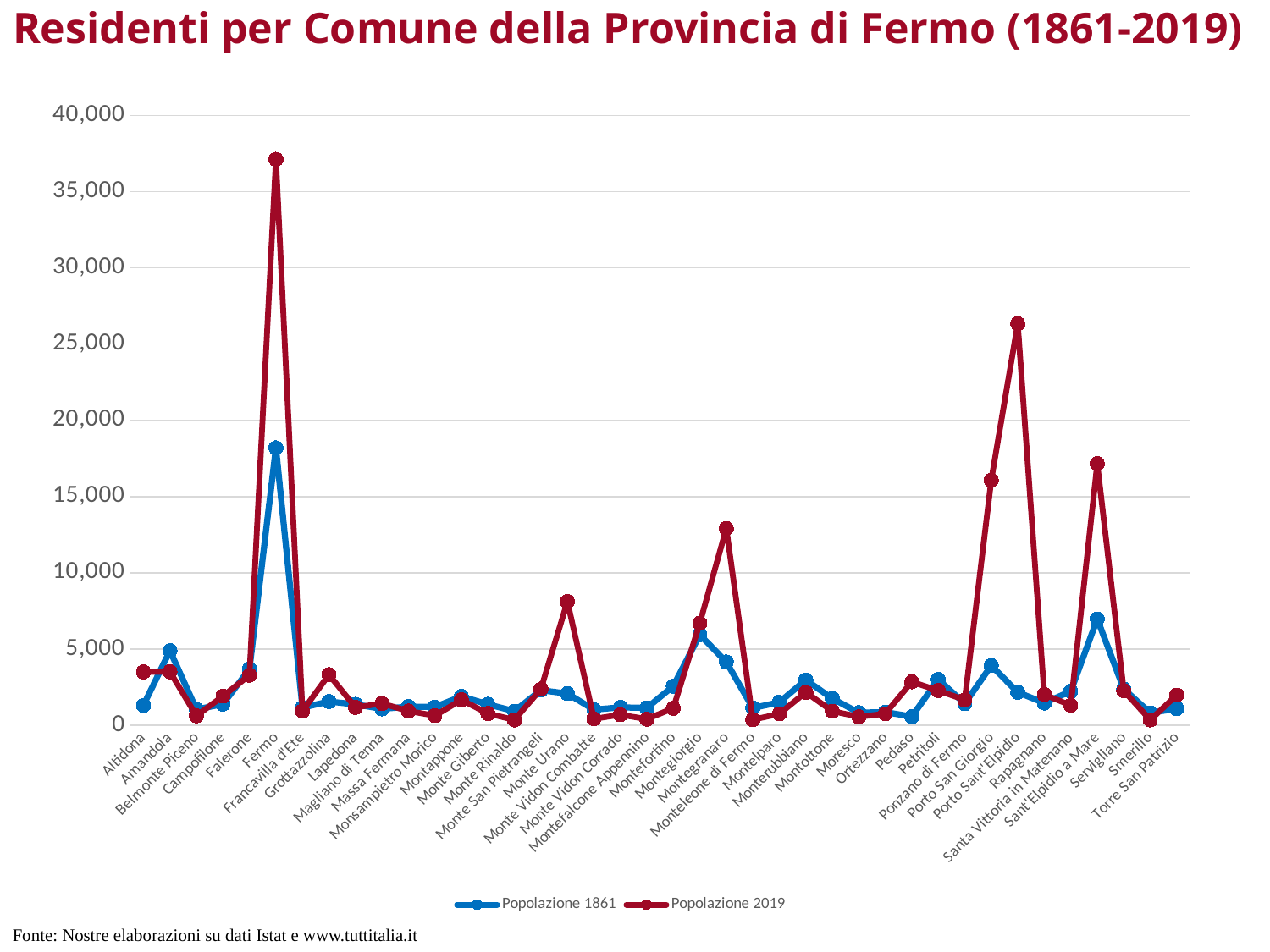
Is the Popolazione 2019 value for Porto San Giorgio greater or less than 15,000? greater How many series does the legend list? 2 Which is larger for Sant'Elpidio a Mare: Popolazione 1861 or Popolazione 2019? Popolazione 2019 Which comune has the highest Popolazione 1861 value? Fermo Is the Popolazione 2019 value for Fermo greater or less than 35,000? greater Is the Popolazione 1861 value for Fermo greater or less than 20,000? less Which comune has the highest Popolazione 2019 value? Fermo How many comuni (categories) are plotted along the x axis? 40 Which is larger for Amandola: Popolazione 1861 or Popolazione 2019? Popolazione 1861 What is the title of the chart? Residenti per Comune della Provincia di Fermo (1861-2019) What kind of chart is shown on the slide? line chart